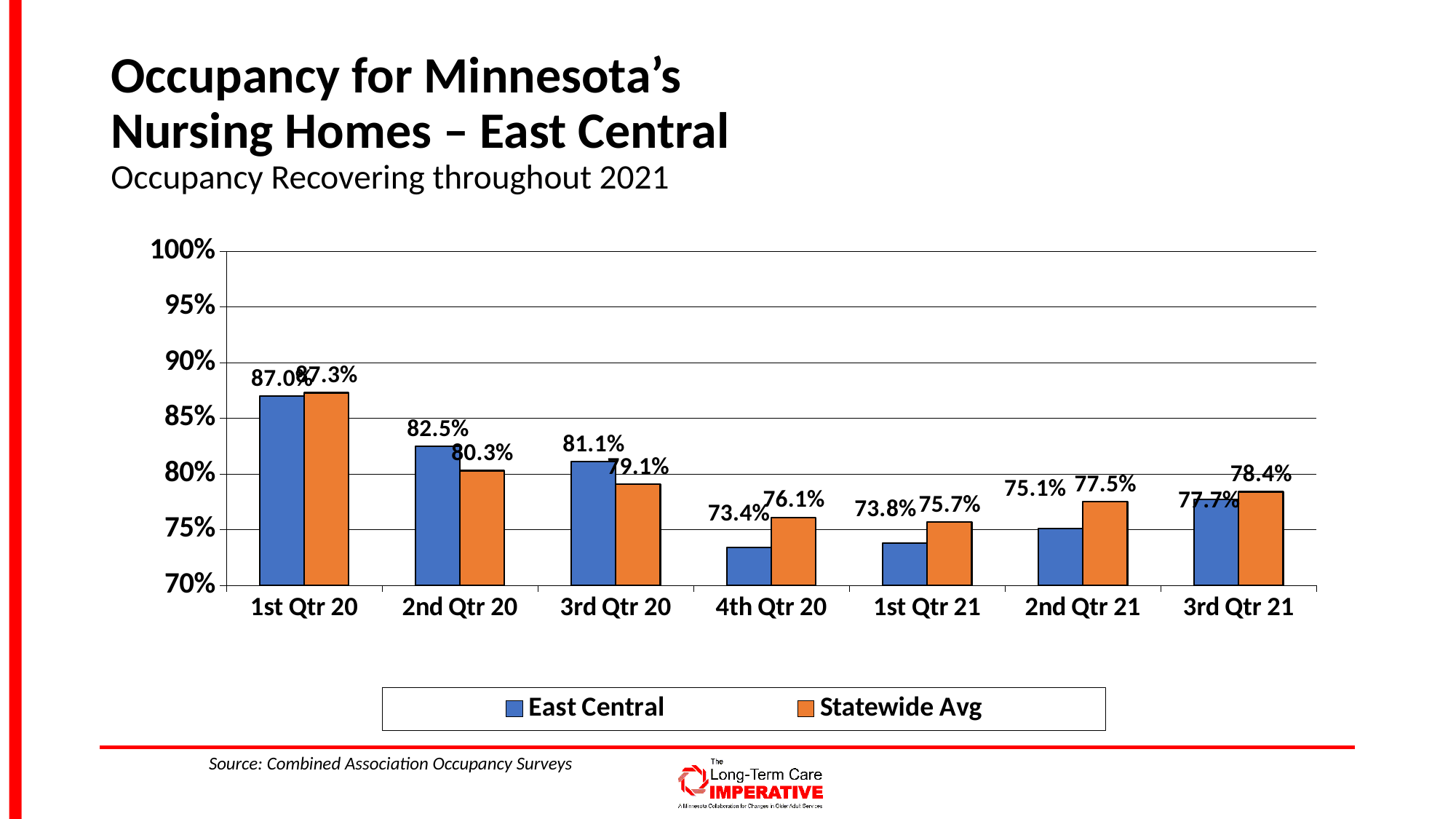
Does the East Central occupancy rise or fall from 4th Qtr 20 to 3rd Qtr 21? rise Is the East Central value for 1st Qtr 21 greater or less than 75%? less How many quarters are shown on the x axis? 7 What is the East Central occupancy value for 3rd Qtr 21? 77.7% In which quarter is the East Central occupancy highest? 1st Qtr 20 What kind of chart is shown on the slide? bar chart How many series does the legend list? 2 In which quarter is the East Central occupancy lowest? 4th Qtr 20 In 3rd Qtr 20, which is larger: East Central or Statewide Avg? East Central What is the East Central occupancy value for 2nd Qtr 20? 82.5% What is the difference between the Statewide Avg and East Central values in 2nd Qtr 21? 2.4% What is the Statewide Avg occupancy value for 4th Qtr 20? 76.1%